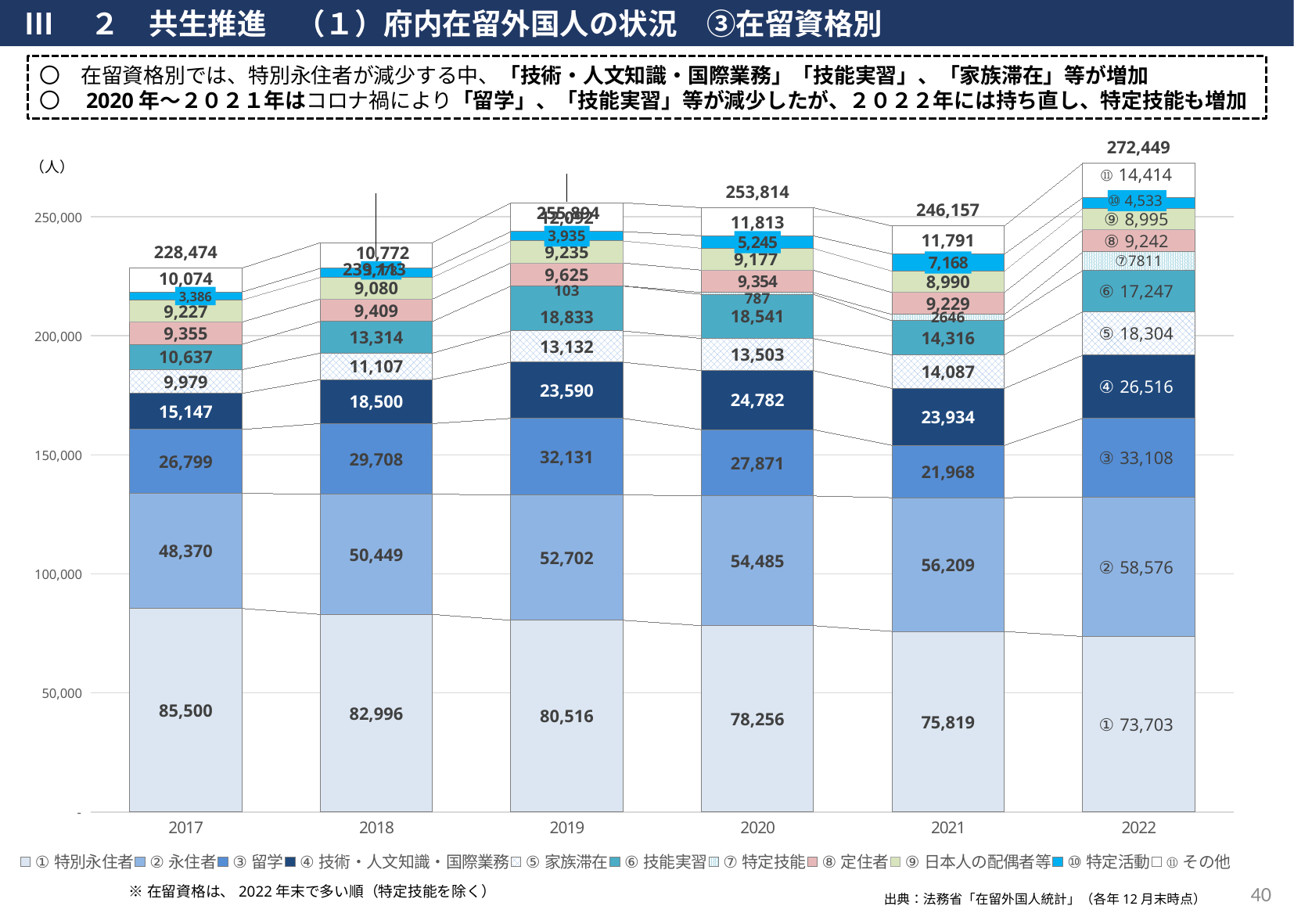
Does the value for ① 特別永住者 rise or fall from 2017 to 2022? fall How many series does the legend list? 11 How many years are shown on the x axis? 6 What is the value for ① 特別永住者 in 2017? 85,500 In which year is the value for ① 特別永住者 the lowest? 2022 In which year is the value for ③ 留学 the highest? 2022 What is the difference between the ④ 技術・人文知識・国際業務 values in 2022 and 2017? 11,369 Which is larger, the ⑥ 技能実習 value in 2019 or in 2021? 2019 What type of chart is shown on the slide? stacked bar chart What is the value for ② 永住者 in 2022? 58,576 What is the value for ③ 留学 in 2021? 21,968 What is the total of the stacked bar for 2022? 272,449